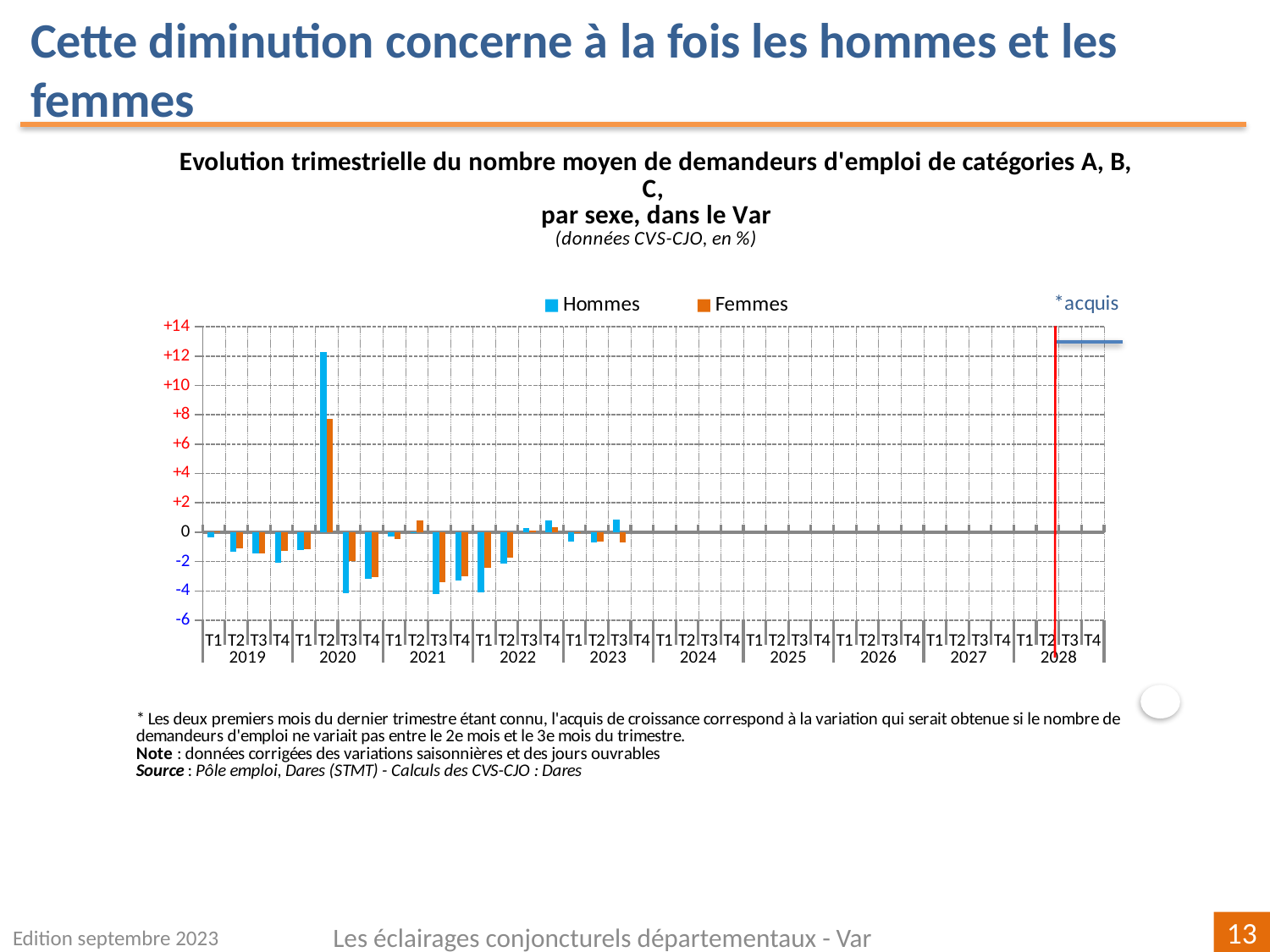
Is the Femmes value for T3 2021 greater or less than -2? less Is the Hommes value for T1 2022 greater or less than -2? less How many years are labelled along the x axis of the chart? 10 What kind of chart is shown on the slide? bar chart Is the Femmes value for T2 2020 greater or less than +6? greater In which quarter does the Hommes series reach its highest value? T2 2020 In T2 2020, which series has the larger value, Hommes or Femmes? Hommes How many series does the chart legend list? 2 Which two series are listed in the chart legend? Hommes and Femmes Which colour represents the Hommes series in the chart? blue